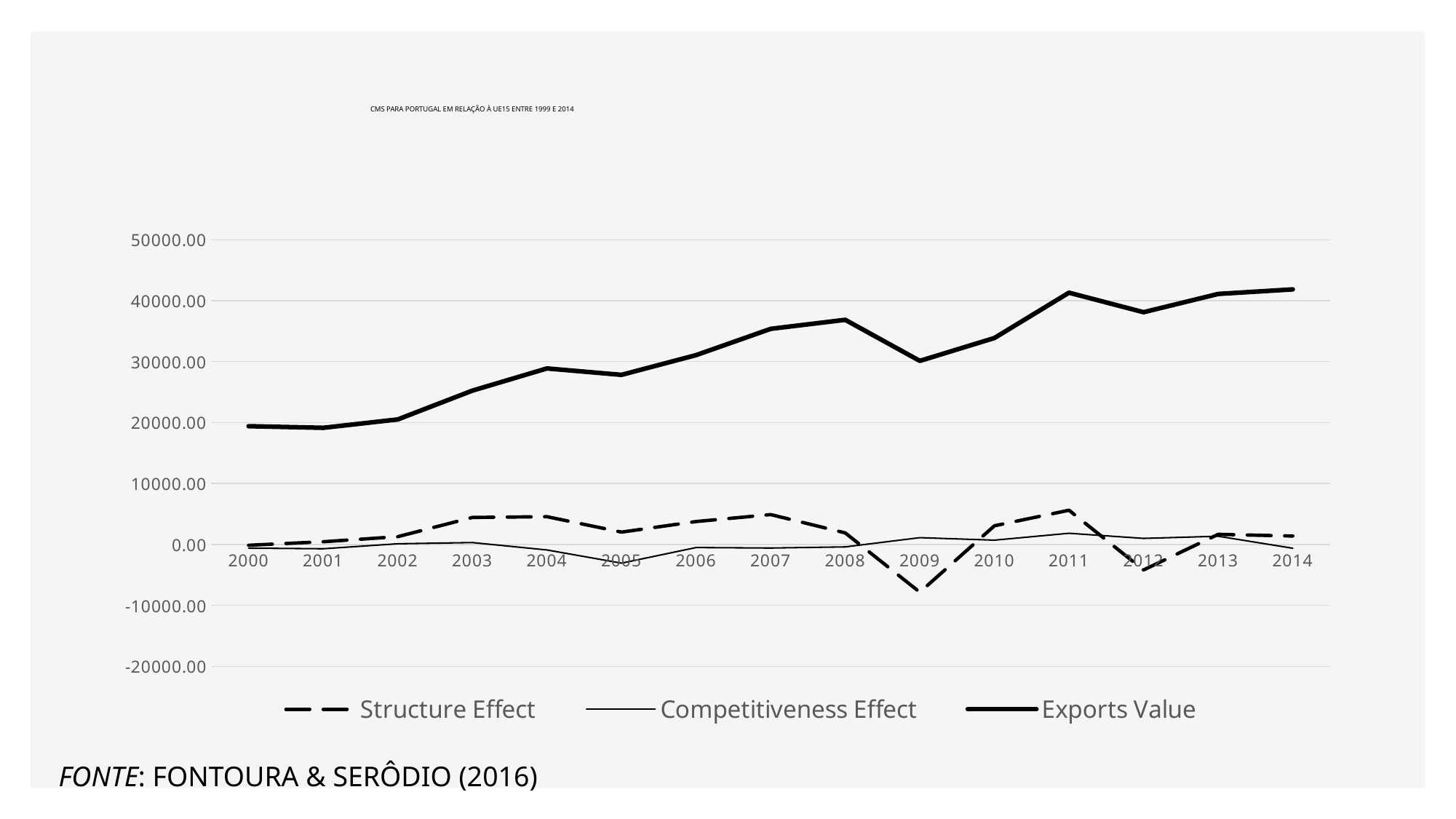
How many years are plotted along the x axis? 15 Is the Exports Value for 2014 greater or less than 40000.00? greater Which series is drawn with a dashed line? Structure Effect How many series does the legend list? 3 Which is larger, the Exports Value in 2008 or in 2009? 2008 Does the Exports Value series generally rise or fall from 2000 to 2014? Rise In which year is the Structure Effect at its lowest? 2009 Which is larger, the Exports Value in 2011 or in 2012? 2011 What kind of chart is shown on the slide? Line chart Is the Exports Value for 2008 greater or less than 30000.00? greater Is the Structure Effect for 2009 greater or less than 0.00? less